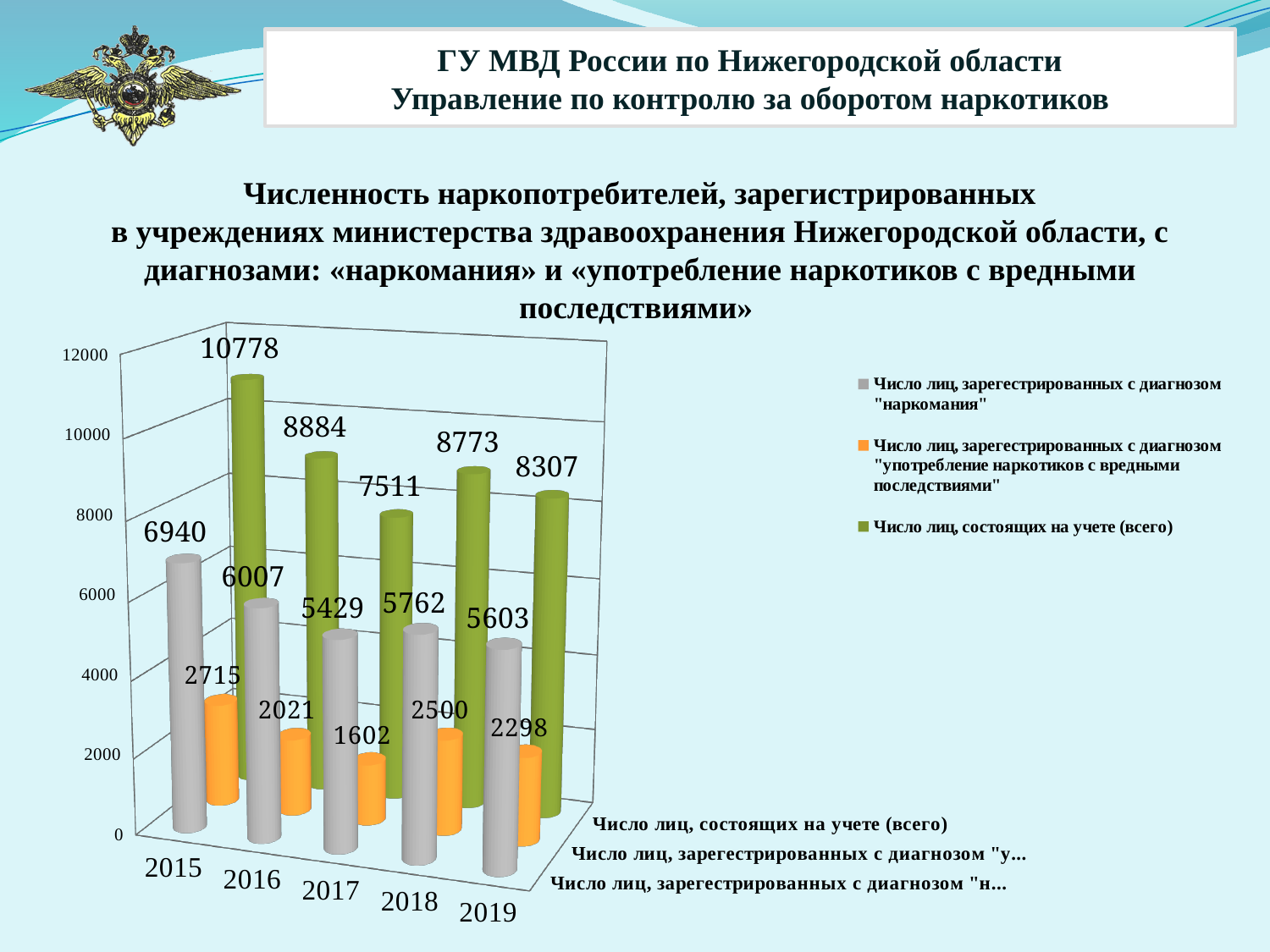
What is the number of persons registered with the diagnosis "наркомания" in 2017? 5429 In which year is the total number of registered persons (всего) the highest? 2015 In which year is the number of persons with the diagnosis "употребление наркотиков с вредными последствиями" the lowest? 2017 What is the difference between the total number of registered persons in 2015 and in 2019? 2471 Which colour represents the series "Число лиц, состоящих на учете (всего)" in the chart? green What kind of chart is shown on the slide? bar chart How many years are shown on the x axis of the chart? 5 How many series does the legend list? 3 What is the total number of registered persons (Число лиц, состоящих на учете (всего)) in 2015? 10778 Which is larger: the number of persons with the diagnosis "наркомания" in 2016 or in 2018? 2016 What is the number of persons registered with the diagnosis "употребление наркотиков с вредными последствиями" in 2018? 2500 Does the total number of registered persons (всего) rise or fall from 2015 to 2017? fall